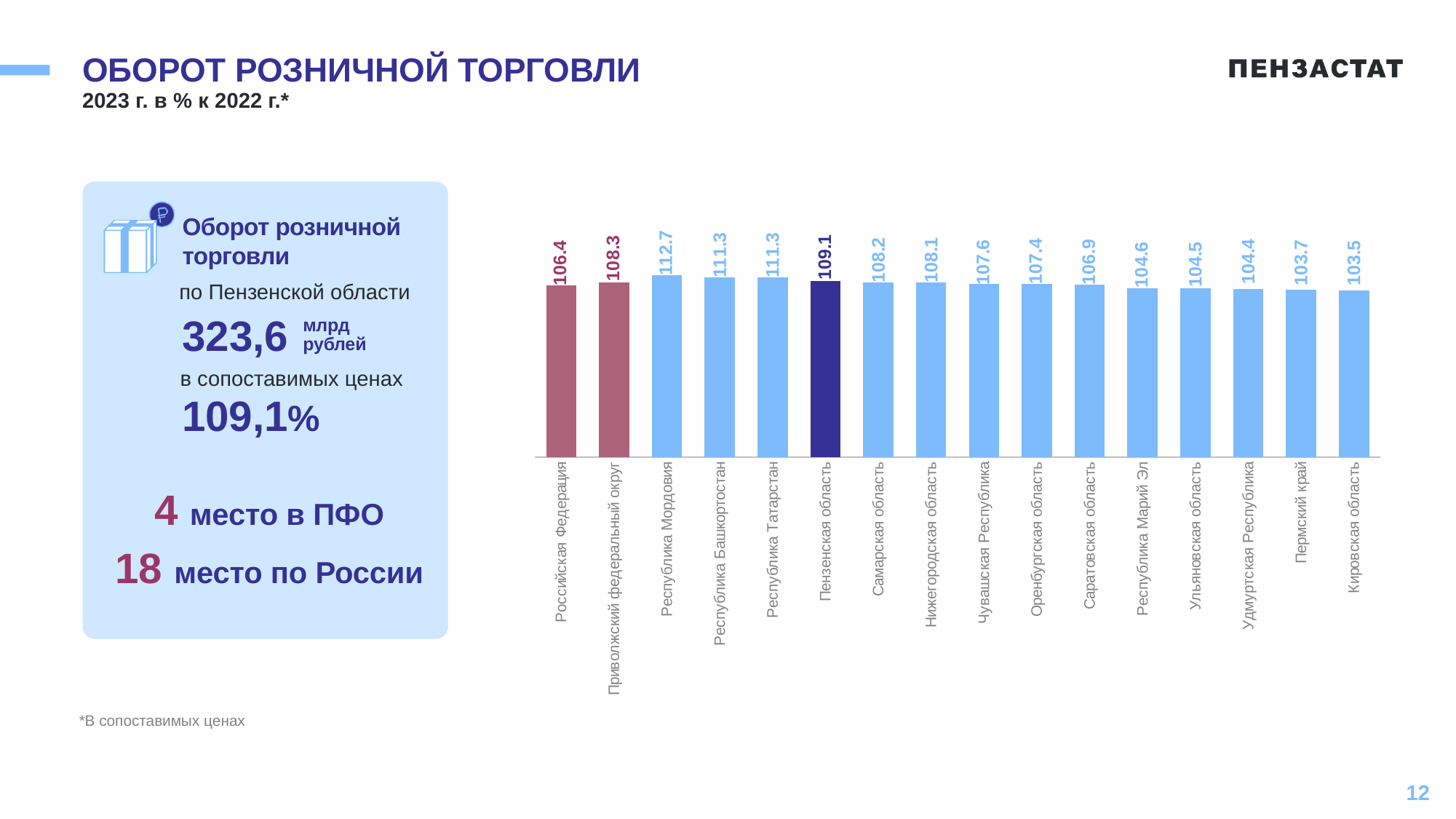
Which category has the lowest value? Кировская область What kind of chart is shown on the slide? Bar chart Which is larger, the value for Самарская область or the value for Чувашская Республика? Самарская область Which category has the highest value? Республика Мордовия What is the difference between the values for Республика Мордовия and Кировская область? 9.2 What is the difference between the values for Пензенская область and Российская Федерация? 2.7 What is the value for Приволжский федеральный округ? 108.3 What is the value for Пермский край? 103.7 What is the value for Российская Федерация? 106.4 How many categories are shown on the chart? 16 What is the title of the slide's chart? ОБОРОТ РОЗНИЧНОЙ ТОРГОВЛИ What is the value for Пензенская область? 109.1